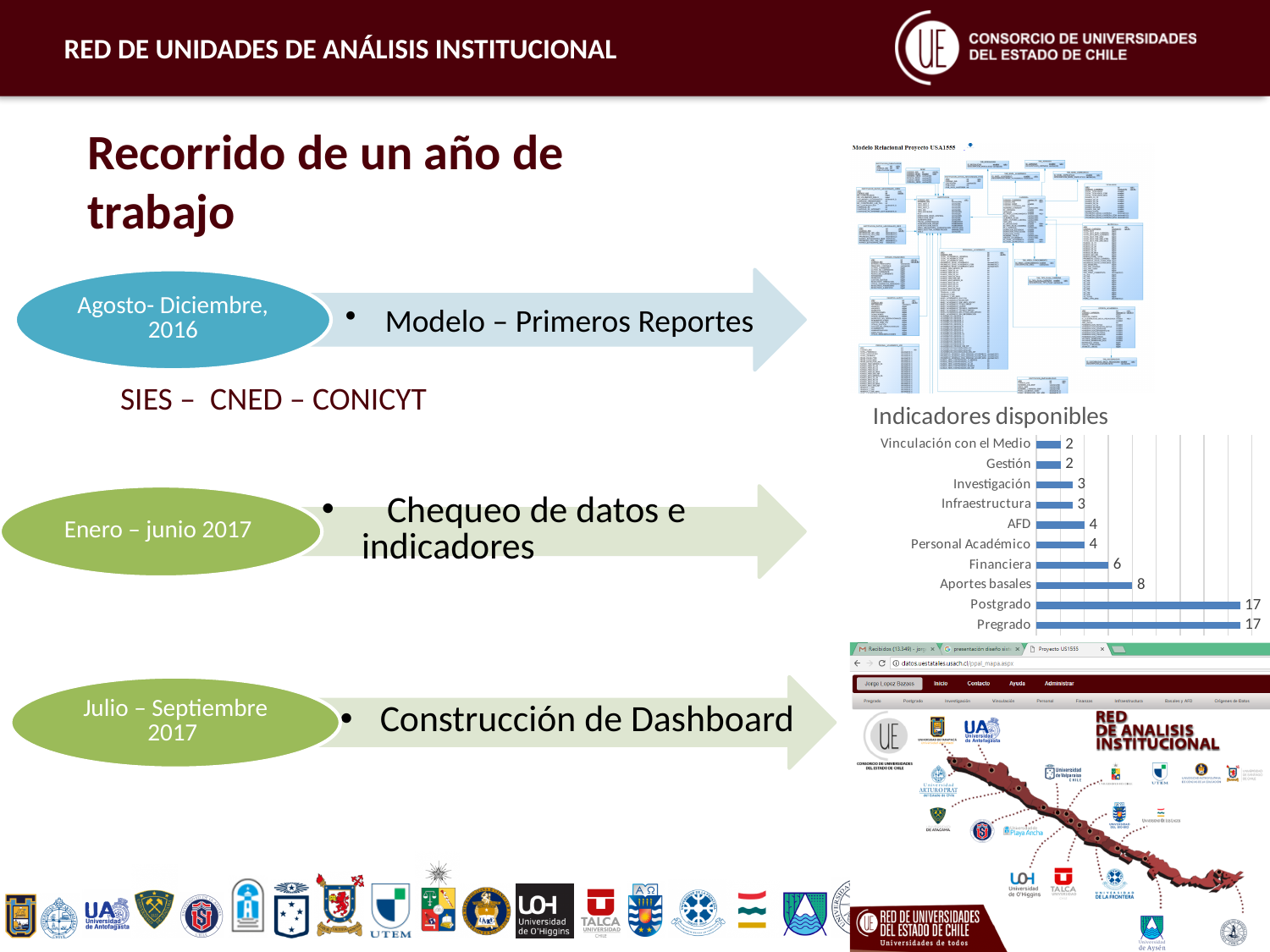
In the 'Indicadores disponibles' chart, what is the difference between Postgrado and Aportes basales? 9 In the 'Indicadores disponibles' chart, what is the value for Financiera? 6 In the 'Indicadores disponibles' chart, what is the difference between Financiera and Investigación? 3 In the 'Indicadores disponibles' chart, what is the value for Gestión? 2 In the 'Indicadores disponibles' chart, what is the value for Aportes basales? 8 In the 'Indicadores disponibles' chart, which is larger, Infraestructura or Vinculación con el Medio? Infraestructura In the 'Indicadores disponibles' chart, what is the value for Pregrado? 17 In the 'Indicadores disponibles' chart, what is the value for AFD? 4 What is the title of the chart on the slide? Indicadores disponibles What kind of chart is 'Indicadores disponibles'? bar chart In the 'Indicadores disponibles' chart, which is larger, Financiera or Personal Académico? Financiera How many categories are shown in the 'Indicadores disponibles' chart? 10